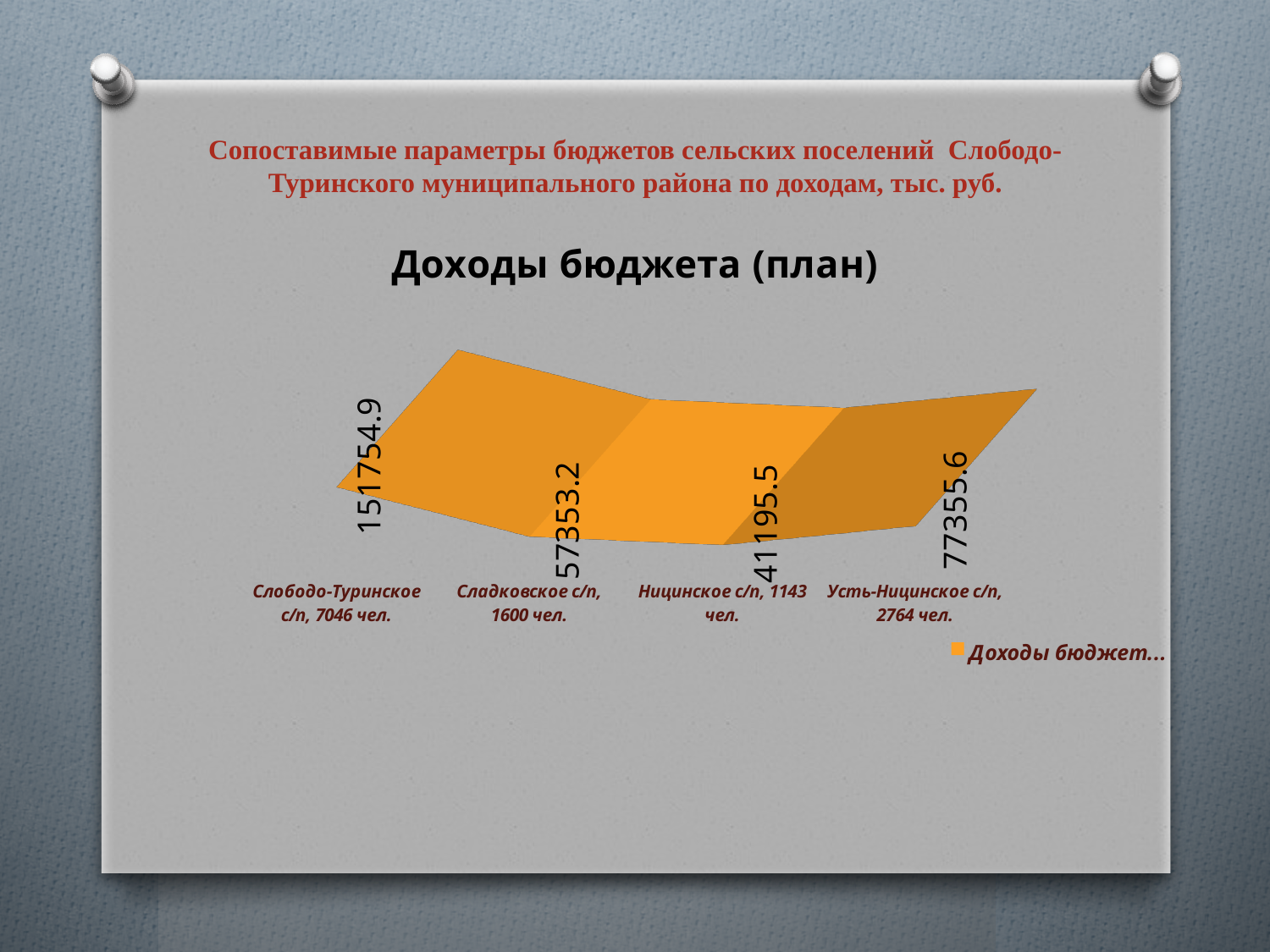
What type of chart is shown on the slide? 3D line chart What is the value for Слободо-Туринское с/п in the chart "Доходы бюджета (план)"? 151754.9 Which settlement has the highest planned budget income in the chart? Слободо-Туринское с/п Which settlement has the lowest planned budget income in the chart? Ницинское с/п What is the difference between the values for Усть-Ницинское с/п and Ницинское с/п? 36160.1 What is the value for Усть-Ницинское с/п in the chart? 77355.6 What is the title of the chart on the slide? Доходы бюджета (план) What is the difference between the values for Слободо-Туринское с/п and Сладковское с/п? 94401.7 How many settlements (categories) are shown in the chart? 4 What is the value for Сладковское с/п in the chart? 57353.2 What is the value for Ницинское с/п in the chart? 41195.5 Which is larger, the value for Сладковское с/п or the value for Усть-Ницинское с/п? Усть-Ницинское с/п